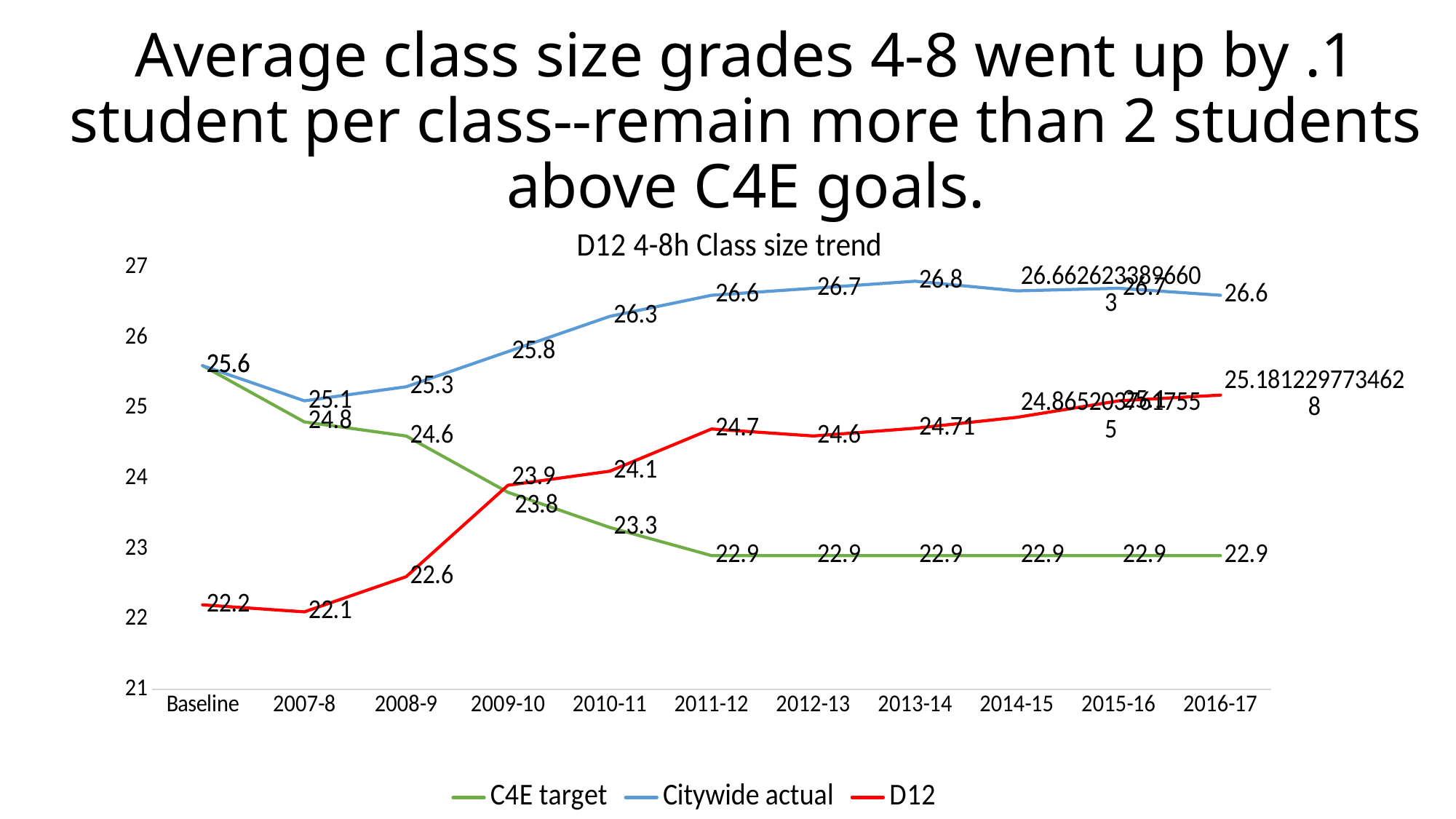
What kind of chart is shown on the slide? line chart How many time points are shown on the x axis? 11 What is the difference between the Citywide actual and D12 values in 2011-12? 1.9 What is the C4E target value for 2010-11? 23.3 Is the Citywide actual value for 2014-15 greater or less than 26? greater How many series does the legend list? 3 In 2010-11, which is larger: the D12 value or the C4E target value? D12 In which year is the D12 series at its lowest value? 2007-8 What is the D12 value for 2013-14? 24.71 In which year does the Citywide actual series reach its highest value? 2013-14 What is the D12 value for 2008-9? 22.6 What is the Citywide actual value for 2011-12? 26.6